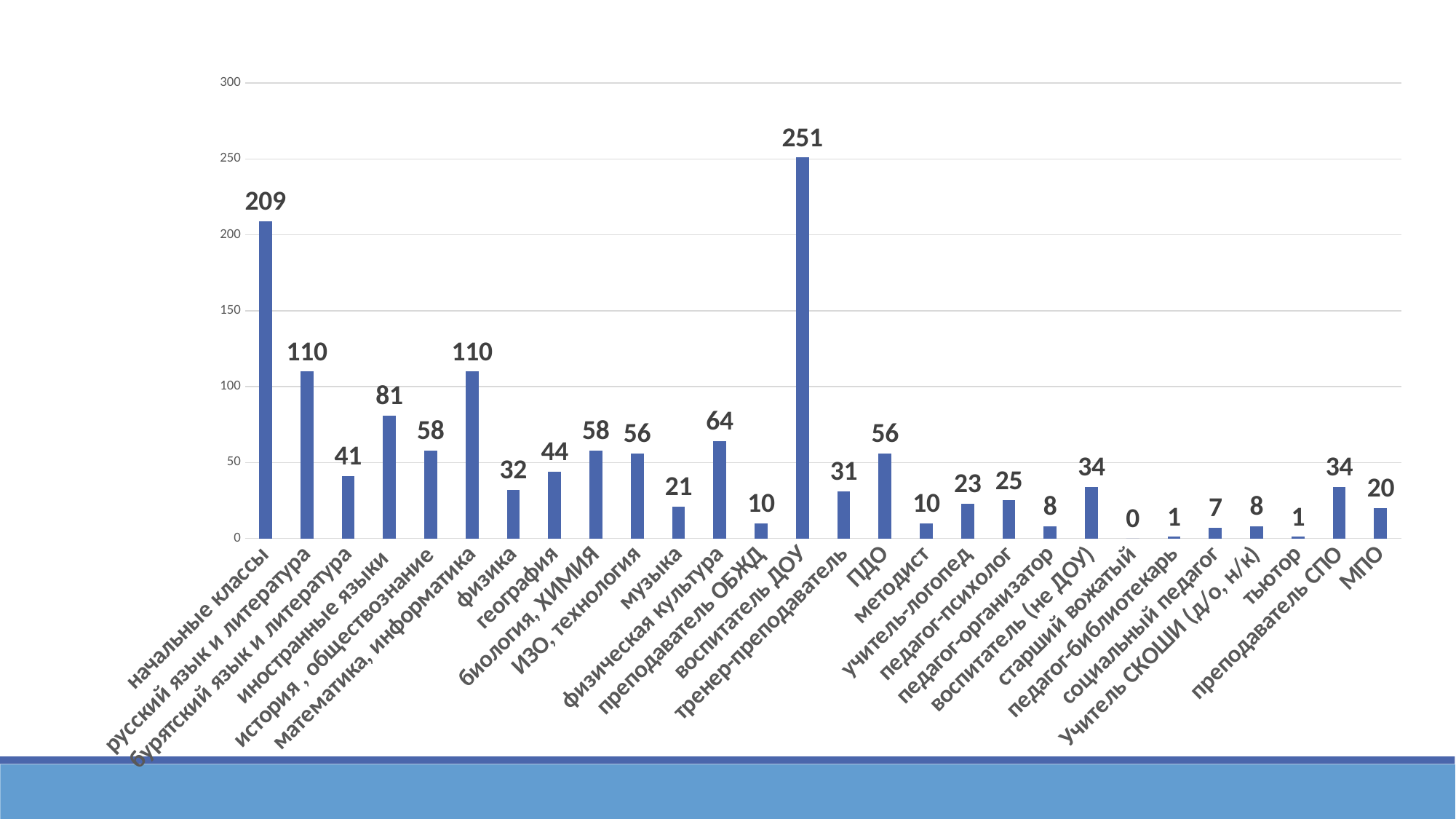
Which is larger, the value for физика or the value for география? география What is the difference between the values for воспитатель ДОУ and начальные классы? 42 Is the value for русский язык и литература greater or less than 100? greater What kind of chart is shown on the slide? bar chart Which category has the lowest value? старший вожатый What is the value for начальные классы? 209 What is the value for педагог-психолог? 25 Which category has the highest value? воспитатель ДОУ What is the value for воспитатель ДОУ? 251 What is the difference between the values for иностранные языки and бурятский язык и литература? 40 What is the value for физическая культура? 64 How many categories are shown on the x axis? 28